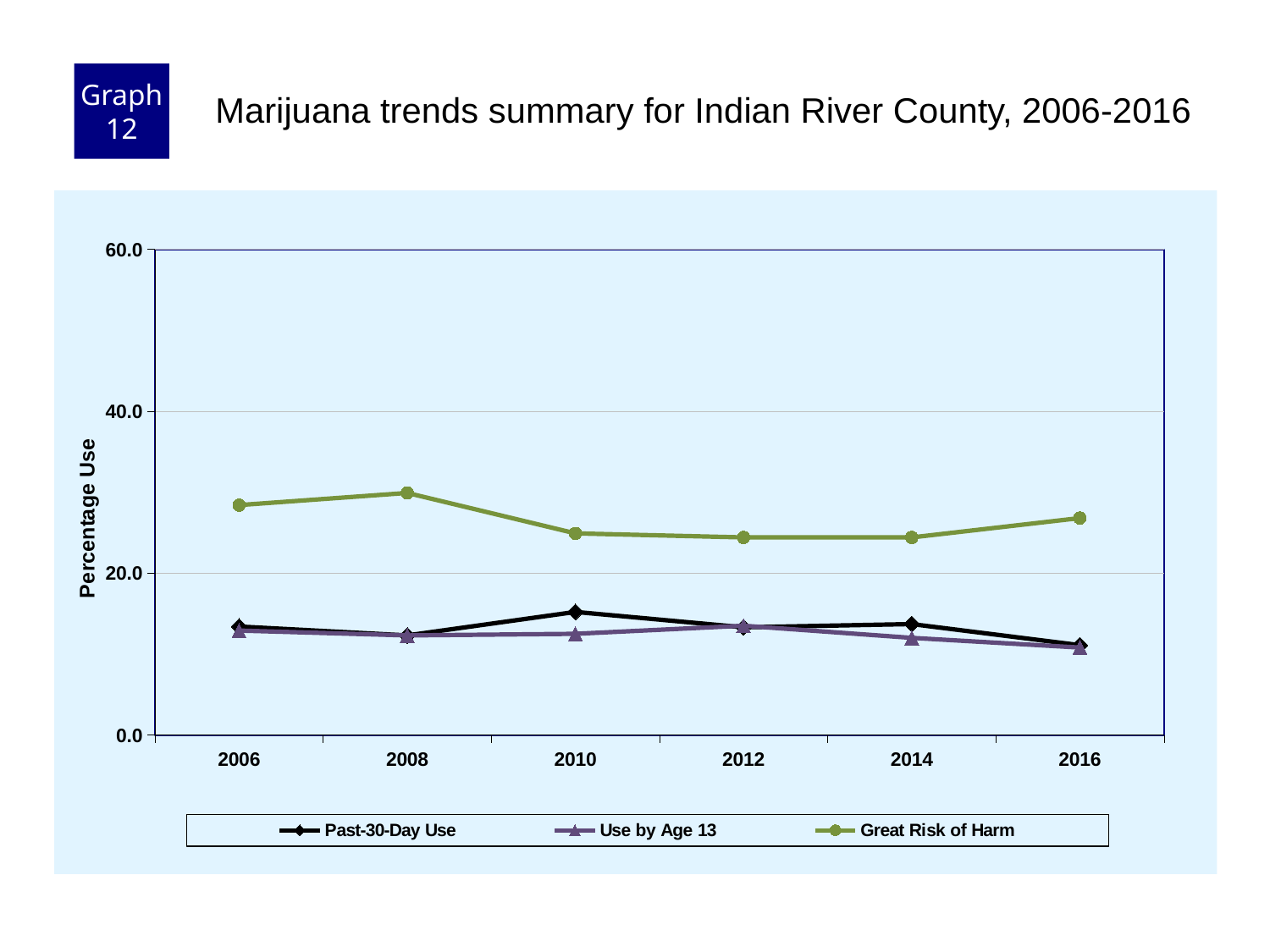
In which year is Past-30-Day Use highest? 2010 How many series does the legend list? 3 Is the value for Past-30-Day Use in 2010 greater or less than 20.0? less What kind of chart is shown on the slide? Line chart Is the value for Great Risk of Harm in 2008 greater or less than 40.0? less In which year is Great Risk of Harm highest? 2008 Does Great Risk of Harm rise or fall from 2008 to 2010? Fall What is the label on the y axis? Percentage Use How many years are plotted along the x axis? 6 In which year is Use by Age 13 lowest? 2016 Which series has the highest values across all years? Great Risk of Harm Is the value for Great Risk of Harm in 2012 greater or less than 20.0? greater